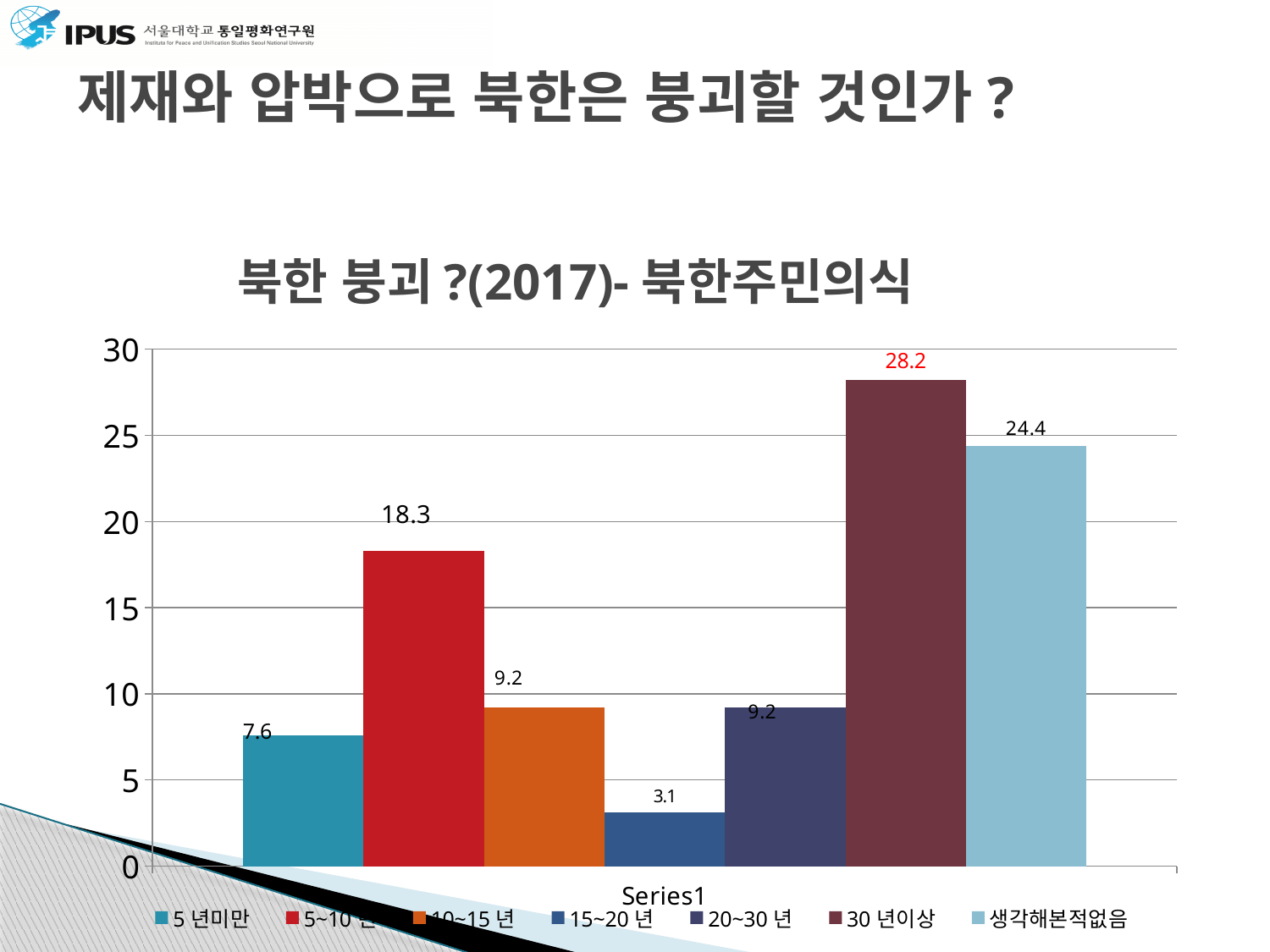
What is the difference between the values for 30 년이상 and 생각해본적없음? 3.8 Is the value for 5~10 년 greater or less than 15? greater What is the difference between the values for 5~10 년 and 5 년미만? 10.7 Which category has the lowest value? 15~20 년 What is the value for 30 년이상? 28.2 What type of chart is shown on the slide? bar chart What is the value for 15~20 년? 3.1 Which category has the highest value? 30 년이상 What is the value for 생각해본적없음? 24.4 Which is larger, the value for 5~10 년 or the value for 20~30 년? 5~10 년 How many bars are shown in the chart? 7 What is the value for 5 년미만? 7.6